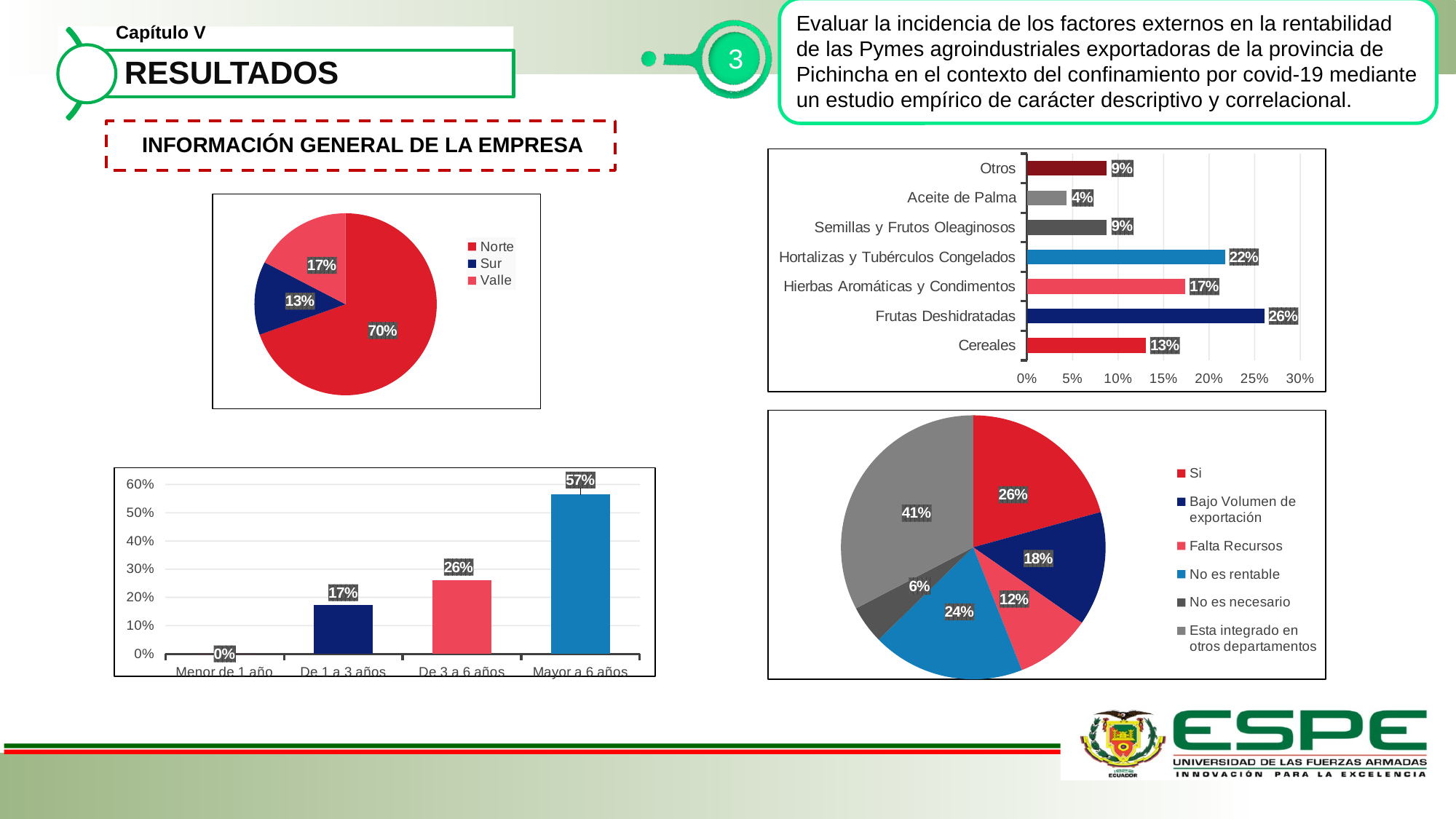
In the bottom-left bar chart, do the values rise or fall from left to right along the x axis? rise In the top-right horizontal bar chart, which is larger, Cereales or Hierbas Aromáticas y Condimentos? Hierbas Aromáticas y Condimentos In the bottom-left bar chart, which category has the highest value? Mayor a 6 años In the top-left pie chart, which category has the smallest share? Sur How many categories does the legend of the top-left pie chart list? 3 In the bottom-left bar chart, what is the difference between Mayor a 6 años and De 1 a 3 años? 40% In the top-left pie chart, what share does Norte have? 70% In the bottom-right pie chart, what share does Esta integrado en otros departamentos have? 41% In the top-right horizontal bar chart, what is the value for Hortalizas y Tubérculos Congelados? 22% How many categories are shown in the top-right horizontal bar chart? 7 In the top-right horizontal bar chart, which category has the highest value? Frutas Deshidratadas In the bottom-left bar chart, what is the value for De 3 a 6 años? 26%